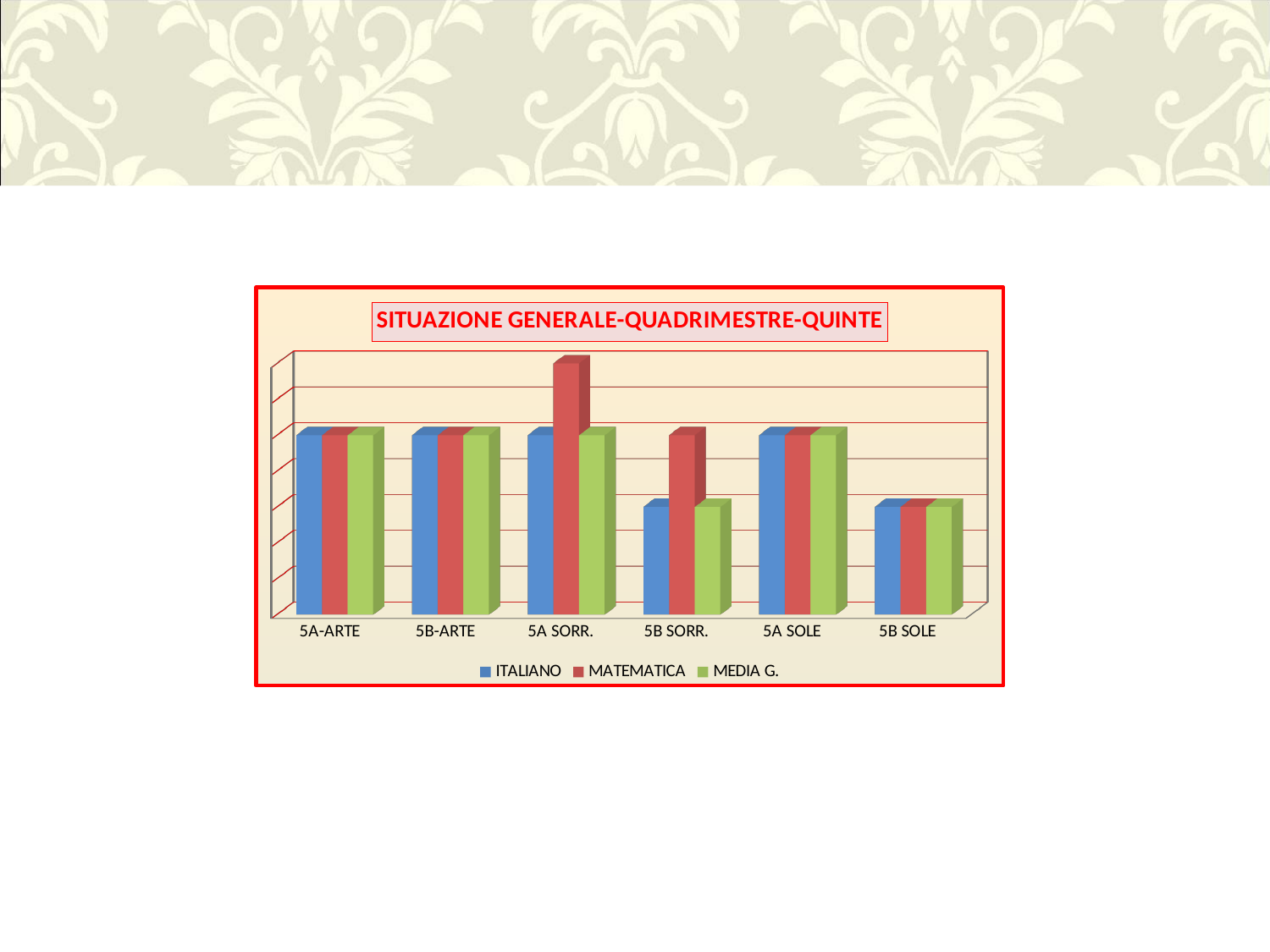
Which series has the highest value for 5B SORR.? MATEMATICA How many series does the legend list? 3 How many categories are shown on the x axis? 6 What kind of chart is shown on the slide? bar chart Which is larger: the MATEMATICA value for 5A SORR. or for 5B SORR.? 5A SORR. Which category has the highest MATEMATICA value? 5A SORR. What is the title of the chart? SITUAZIONE GENERALE-QUADRIMESTRE-QUINTE Which is larger: the ITALIANO value for 5A SOLE or for 5B SOLE? 5A SOLE Which is larger: the MEDIA G. value for 5A-ARTE or for 5B SORR.? 5A-ARTE Which series is shown in red in the legend? MATEMATICA Which series has the highest value for 5A SORR.? MATEMATICA